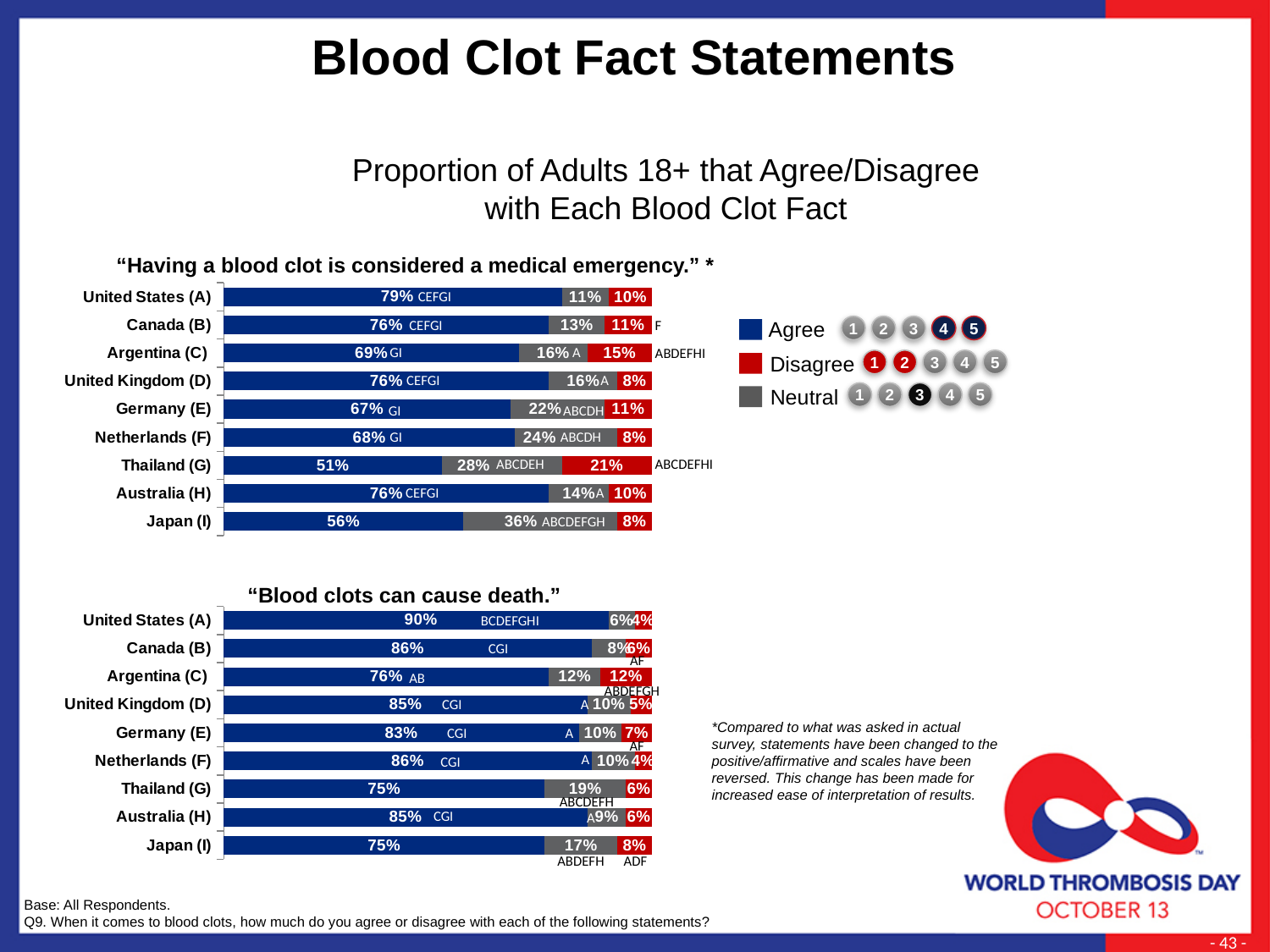
In the chart "Blood clots can cause death.", what is the Agree percentage for Argentina (C)? 76% In the chart "Blood clots can cause death.", which country has the highest Agree percentage? United States (A) In the chart "Having a blood clot is considered a medical emergency.", which country has the lowest Agree percentage? Thailand (G) How many countries are shown in the chart "Blood clots can cause death."? 9 How many series does the legend list for the charts on this slide? 3 In the chart "Having a blood clot is considered a medical emergency.", what percentage of adults in the United States (A) agree? 79% In the chart "Having a blood clot is considered a medical emergency.", what is the Neutral percentage for Japan (I)? 36% In the chart "Blood clots can cause death.", which is larger: the Agree percentage for Canada (B) or for Germany (E)? Canada (B) In the chart "Having a blood clot is considered a medical emergency.", what is the Disagree percentage for Thailand (G)? 21% In the chart "Having a blood clot is considered a medical emergency.", what is the difference between the Agree percentages for the United States (A) and Germany (E)? 12% In the chart "Blood clots can cause death.", what is the Neutral percentage for Thailand (G)? 19% What type of chart is used for "Having a blood clot is considered a medical emergency."? Stacked bar chart